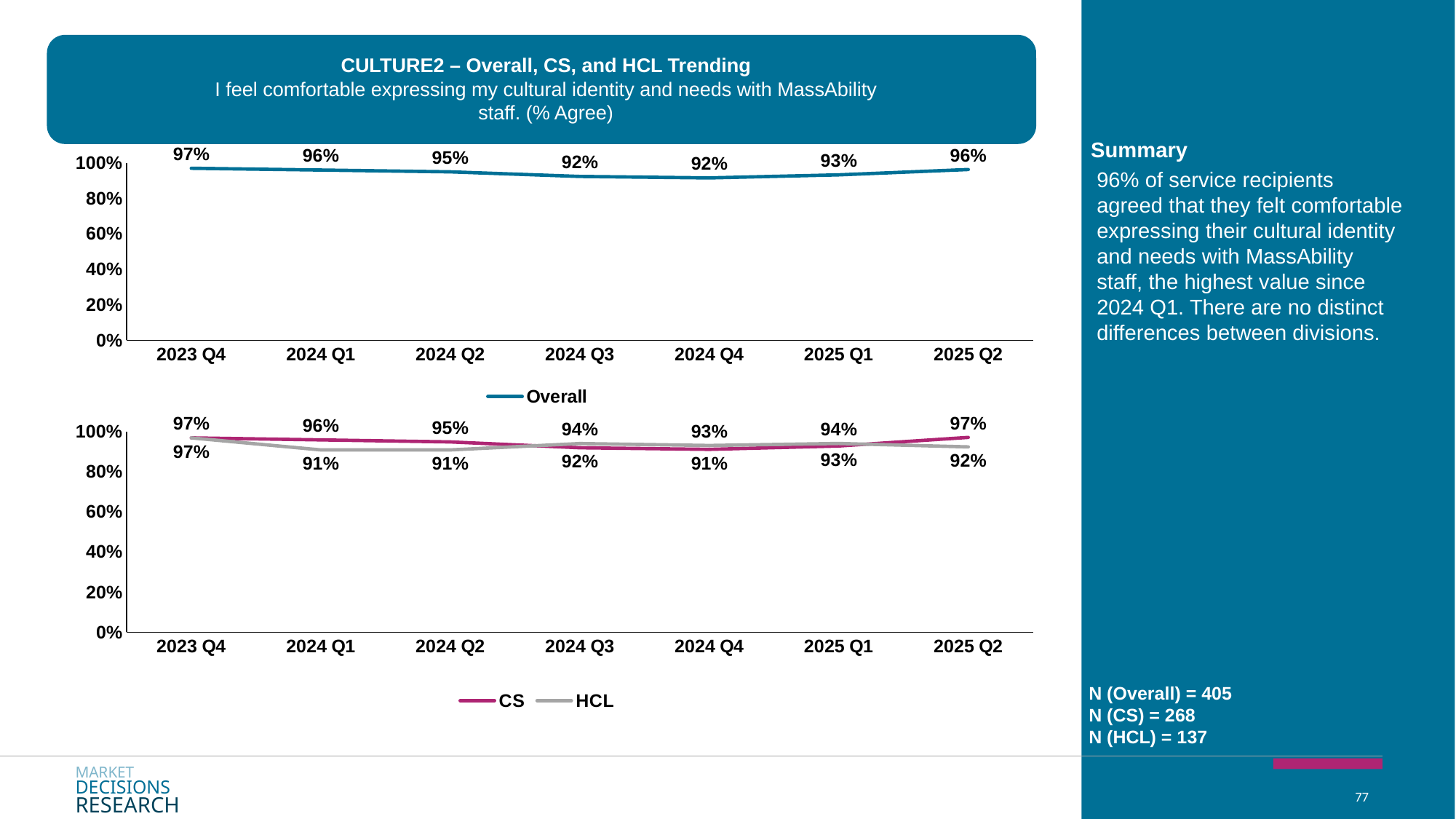
In the top chart (Overall), what is the difference between the 2023 Q4 value and the 2024 Q4 value? 5% In the bottom chart (CS and HCL), what is the HCL value for 2025 Q1? 94% In the bottom chart (CS and HCL), which series has the larger value in 2024 Q1, CS or HCL? CS In the bottom chart (CS and HCL), what is the CS value for 2024 Q4? 91% In the top chart (Overall), what is the value for 2025 Q2? 96% In the top chart (Overall), what is the value for 2024 Q3? 92% In the bottom chart (CS and HCL), which quarter has the lowest HCL value? 2024 Q1 and 2024 Q2 (both 91%) In the top chart (Overall), which quarter has the highest value? 2023 Q4 What kind of chart is the top chart (Overall)? Line chart In the bottom chart (CS and HCL), how many series does the legend list? 2 In the bottom chart (CS and HCL), what is the difference between the CS and HCL values in 2025 Q2? 5% In the top chart (Overall), how many quarters are plotted? 7